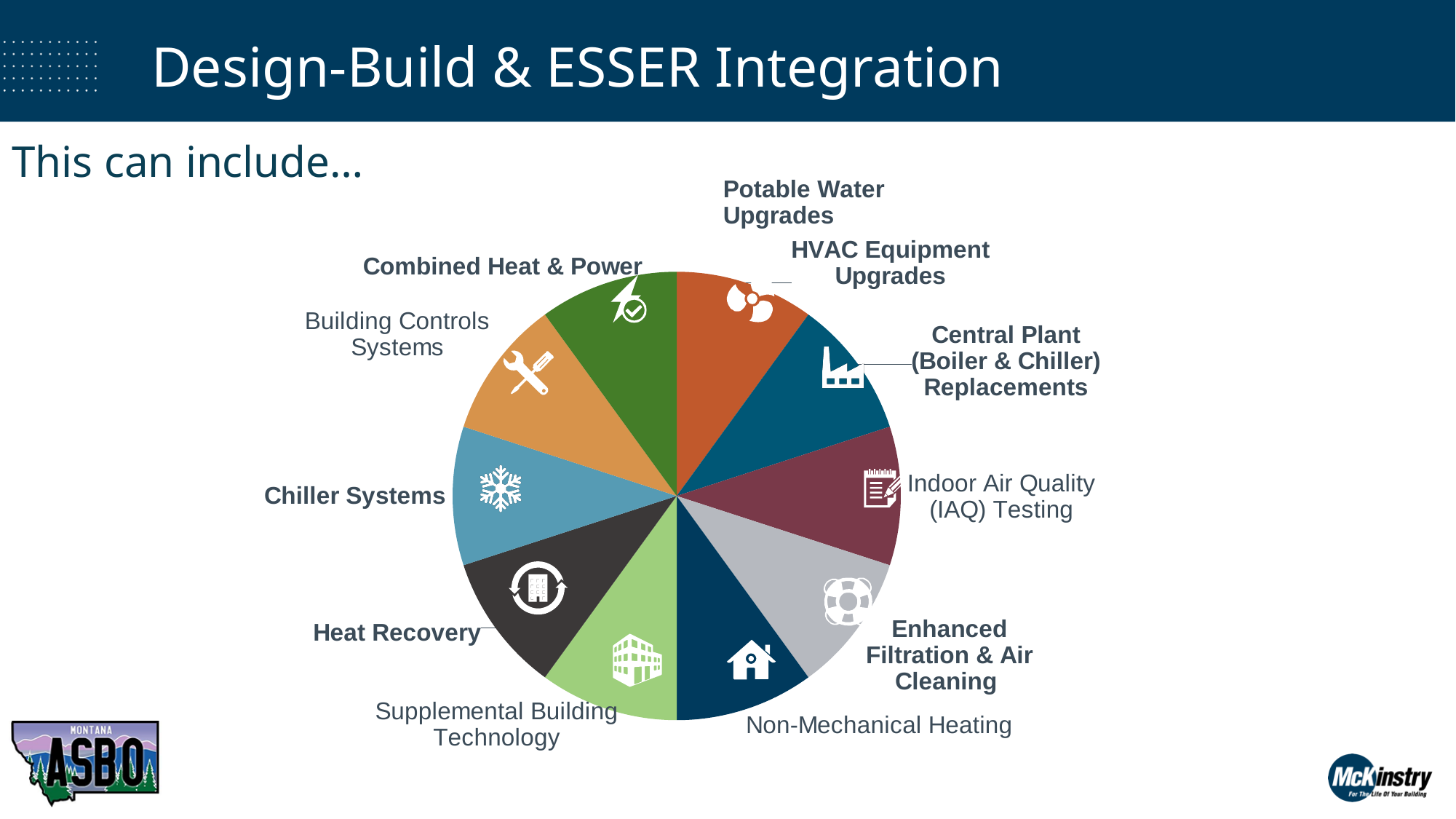
What is the heading text above the pie chart on the left? This can include... Which category is labelled directly below the pie chart, to the right of Supplemental Building Technology? Non-Mechanical Heating How many categories are labelled around the pie chart? 11 Which category label appears at the top left of the pie chart, above Building Controls Systems? Combined Heat & Power Does the pie chart print any numeric values or percentages on its slices? No What kind of chart is shown on the slide? pie chart Which category's slice is labelled with a snowflake icon? Chiller Systems Which category is labelled on the right side of the pie chart with the text '(IAQ) Testing'? Indoor Air Quality (IAQ) Testing